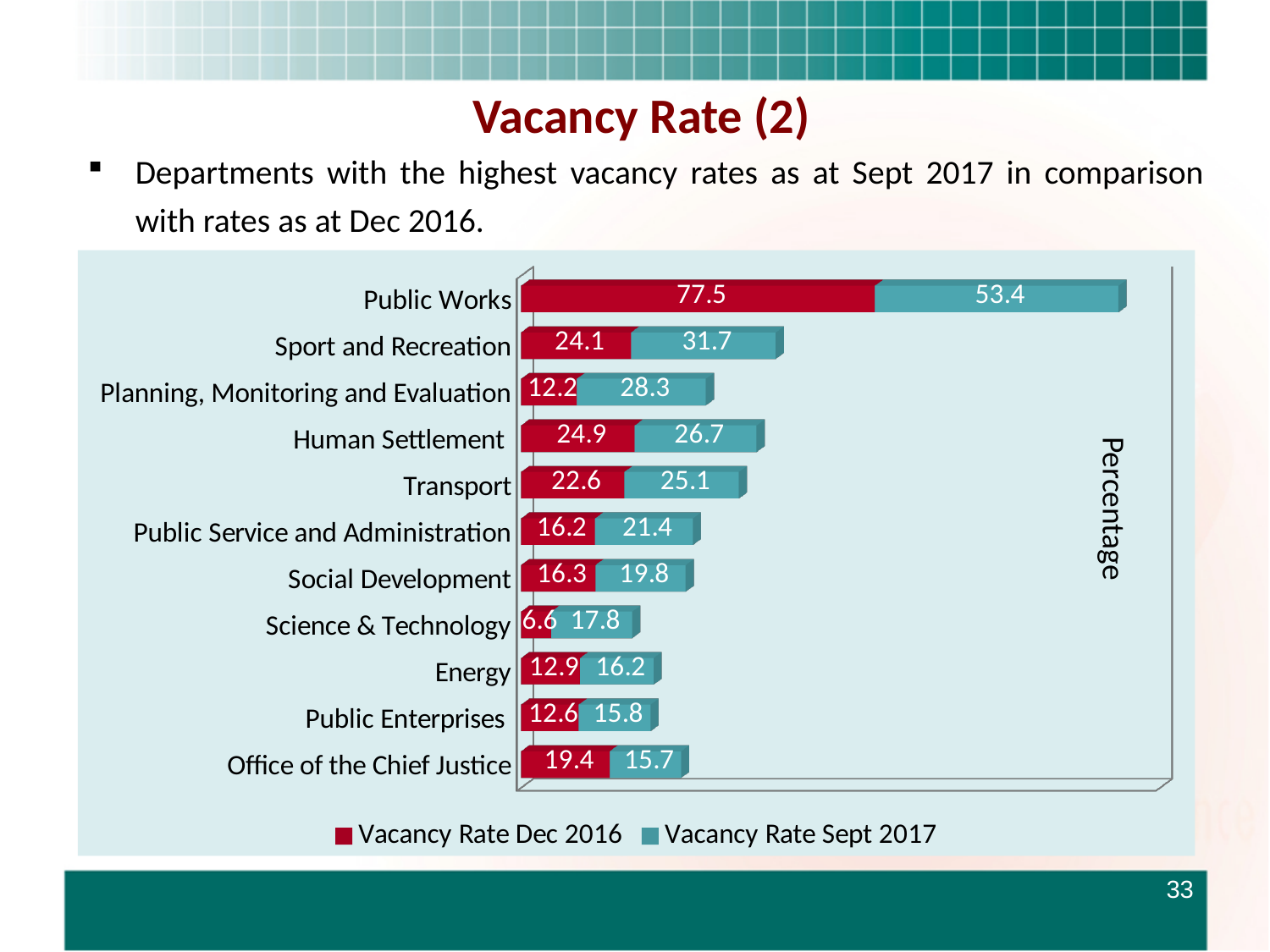
How many departments are shown in the chart? 11 Which department has the lowest Vacancy Rate Sept 2017? Office of the Chief Justice What kind of chart is shown on the slide? Bar chart How many series does the legend list? 2 What is the total of the stacked bar for Transport? 47.7 What is the difference between the Vacancy Rate Dec 2016 and the Vacancy Rate Sept 2017 for Public Works? 24.1 What is the label on the axis at the right side of the chart? Percentage What is the Vacancy Rate Sept 2017 for Public Works? 53.4 What is the Vacancy Rate Sept 2017 for Science & Technology? 17.8 What is the Vacancy Rate Dec 2016 for Sport and Recreation? 24.1 Which department has the highest Vacancy Rate Dec 2016? Public Works Which is larger for Office of the Chief Justice: the Vacancy Rate Dec 2016 or the Vacancy Rate Sept 2017? Vacancy Rate Dec 2016